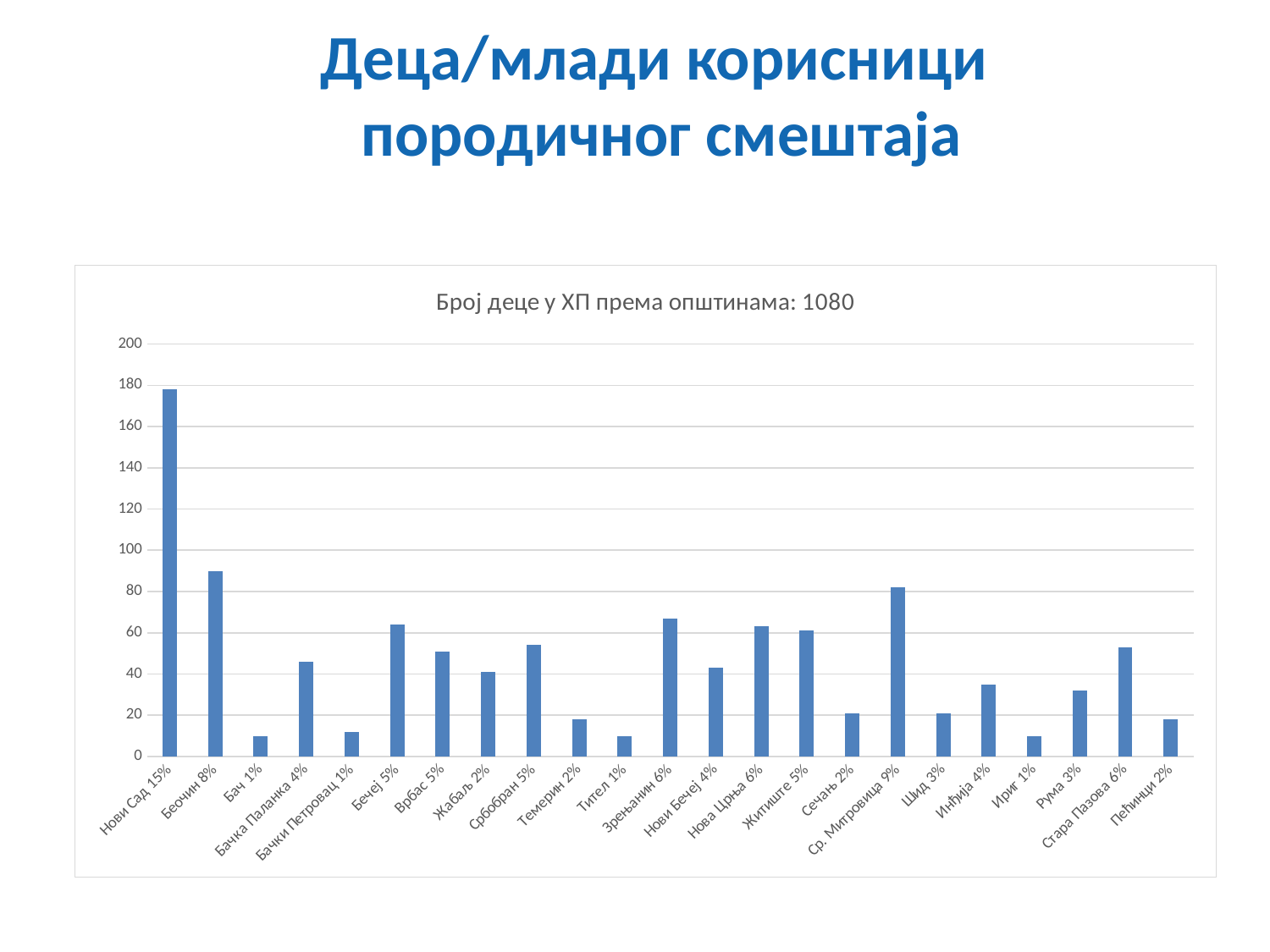
How many municipalities (categories) are shown on the x axis of the chart? 23 Which has the larger value, Беочин or Ср. Митровица? Беочин What is the title of the chart? Број деце у ХП према општинама: 1080 Which municipality has the highest bar in the chart? Нови Сад Is the value for Нови Сад greater or less than 160? greater Is the value for Зрењанин greater or less than 60? greater Is the value for Бачка Паланка greater or less than 60? less What percentage is shown in the axis label for Нови Сад? 15% Which has the larger value, Бечеј or Жабаљ? Бечеј What type of chart is shown on the slide? bar chart What percentage is shown in the axis label for Ср. Митровица? 9%